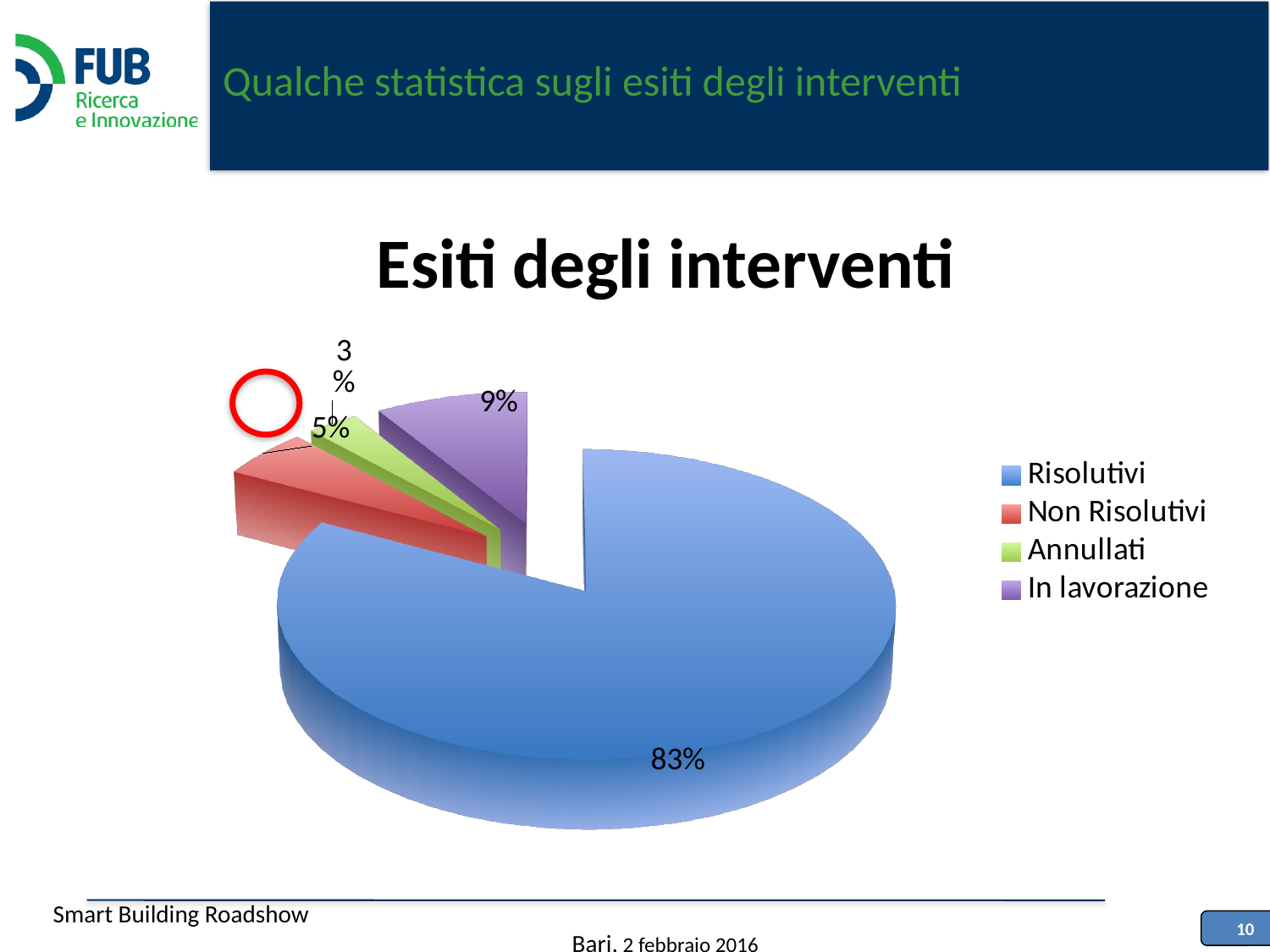
Which category has the largest share of the pie? Risolutivi What percentage of the pie is Risolutivi? 83% What percentage of the pie is In lavorazione? 9% Is the share for Risolutivi greater or less than 50%? greater Which is larger, the share for Risolutivi or the share for In lavorazione? Risolutivi What is the difference in percentage points between Risolutivi and In lavorazione? 74 What is the title of the chart? Esiti degli interventi How many entries does the legend list? 4 How many slices does the pie chart have? 4 Which colour represents In lavorazione in the chart? purple What kind of chart is shown on the slide? pie chart